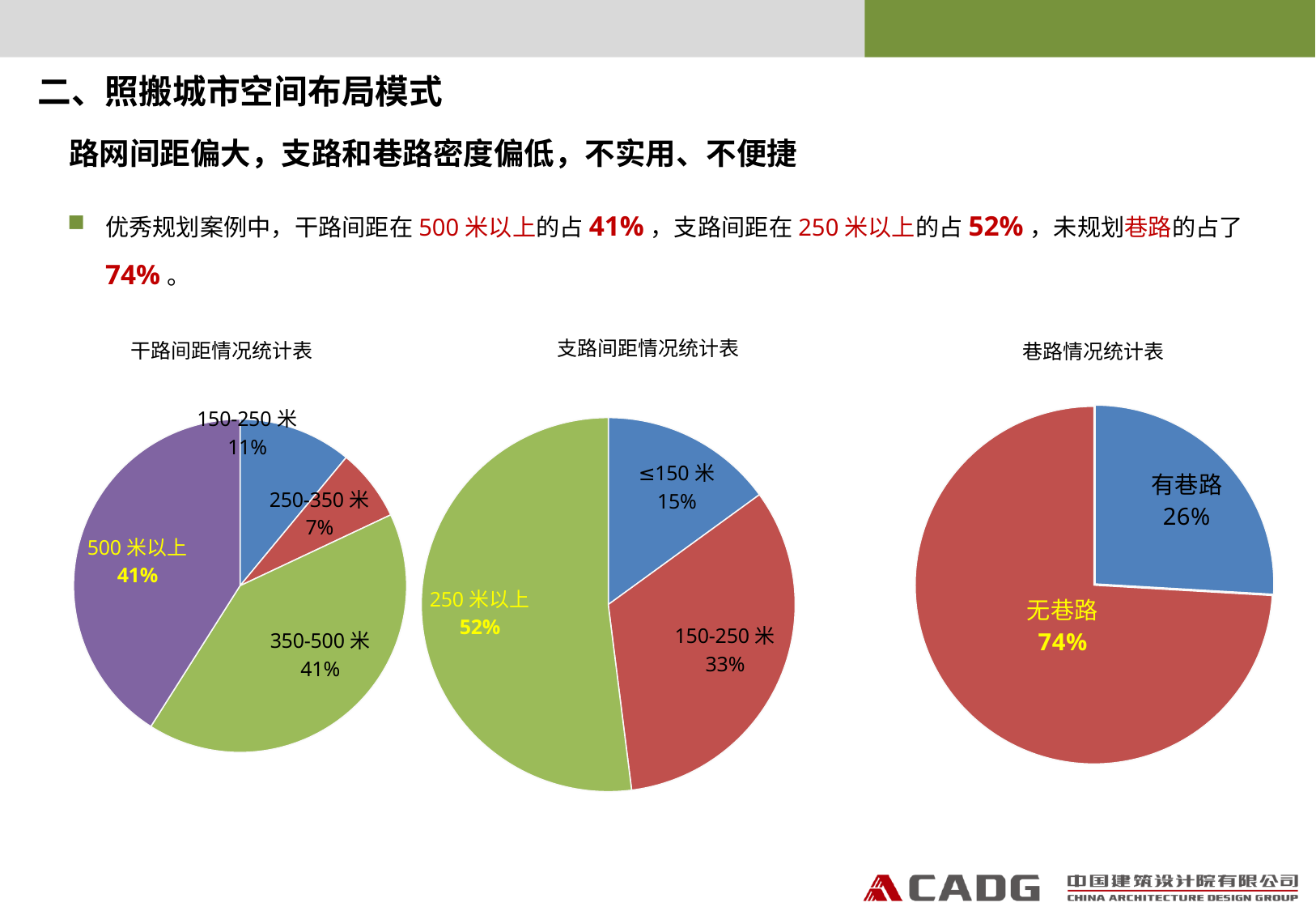
In the 巷路情况统计表 chart, which category has the largest share? 无巷路 In the 巷路情况统计表 chart, what share does 有巷路 have? 26% In the 干路间距情况统计表 chart, what share does 250-350 米 have? 7% In the 支路间距情况统计表 chart, which is larger, ≤150 米 or 150-250 米? 150-250 米 In the 支路间距情况统计表 chart, which category has the largest share? 250 米以上 In the 干路间距情况统计表 chart, which category has the smallest share? 250-350 米 In the 干路间距情况统计表 chart, what is the difference between the shares of 150-250 米 and 250-350 米? 4% What kind of chart is the 巷路情况统计表 chart? Pie chart In the 干路间距情况统计表 chart, how many slices does the pie have? 4 In the 支路间距情况统计表 chart, what is the difference between the shares of 250 米以上 and ≤150 米? 37% In the 支路间距情况统计表 chart, what share does 150-250 米 have? 33% How many charts are shown on the slide? 3